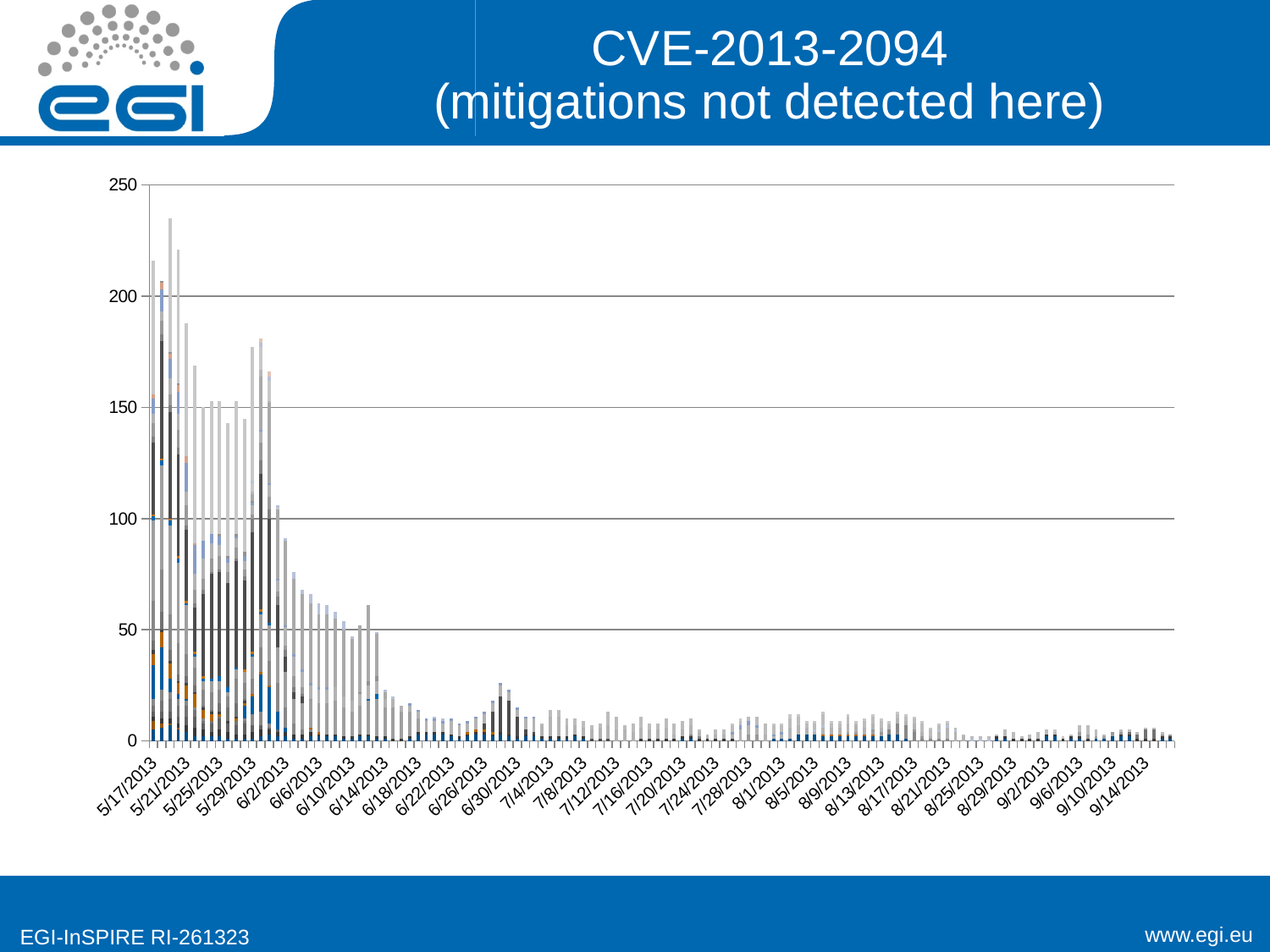
Is the value for 6/14/2013 greater or less than 100? less Is the value for 9/14/2013 greater or less than 50? less Do the values generally rise or fall from left to right along the date axis? fall Is the value for 5/17/2013 greater or less than 200? greater Which has the larger value, 5/17/2013 or 7/4/2013? 5/17/2013 What is the title of the chart on the slide? CVE-2013-2094 (mitigations not detected here) Which has the larger value, 5/17/2013 or 9/14/2013? 5/17/2013 What kind of chart is shown on the slide? bar chart What is the highest value shown on the vertical axis of the chart? 250